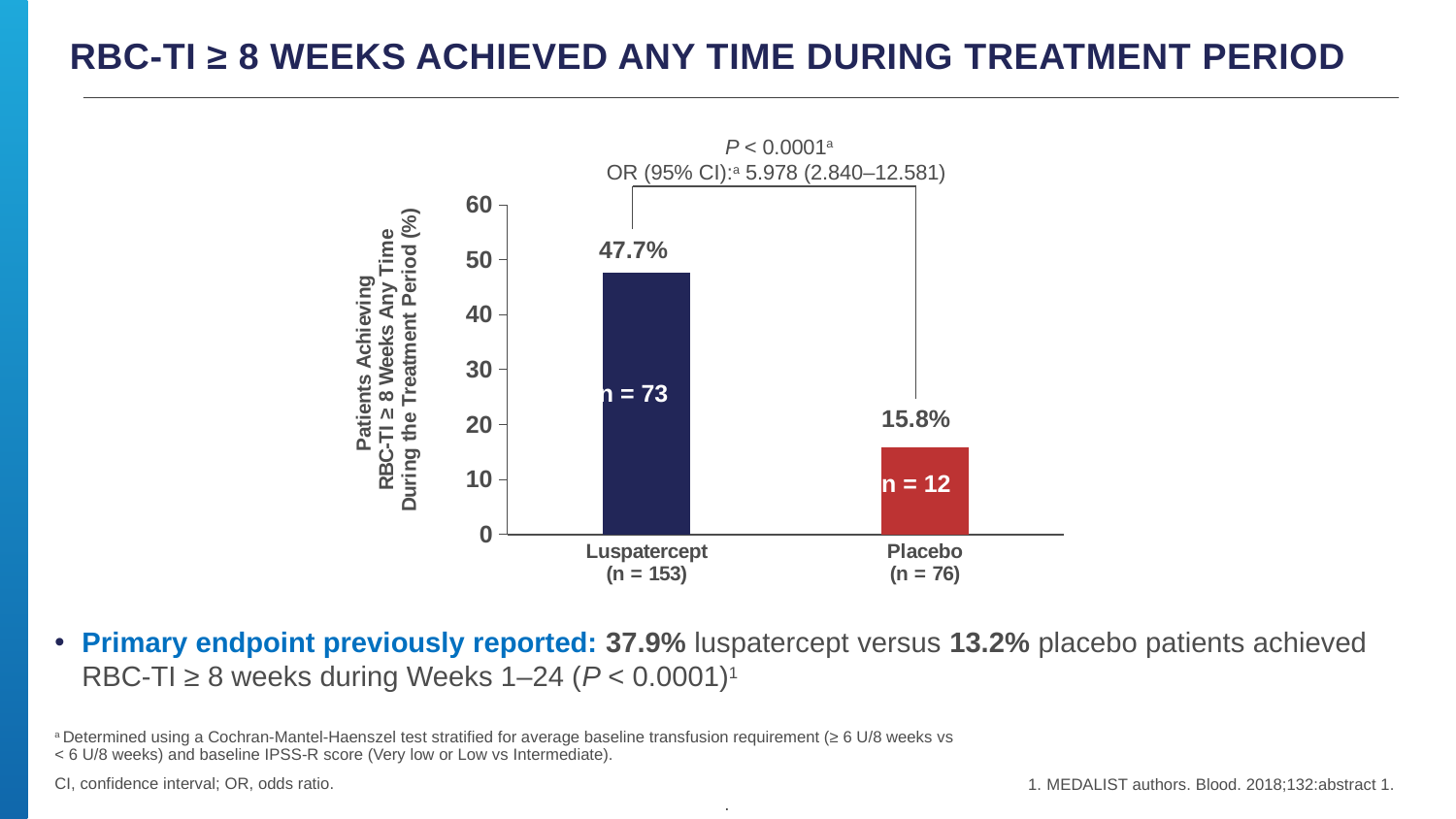
Is the value for the placebo bar greater or less than 20? less Which treatment group has the lower percentage of patients achieving RBC-TI ≥ 8 weeks? Placebo How many patients in the placebo group achieved RBC-TI ≥ 8 weeks (n shown on the bar)? n = 12 What is the odds ratio (95% CI) shown above the chart? 5.978 (2.840–12.581) How many patients in the luspatercept group achieved RBC-TI ≥ 8 weeks (n shown on the bar)? n = 73 What is the difference in percentage points between the luspatercept and placebo bars? 31.9 What percentage of luspatercept patients achieved RBC-TI ≥ 8 weeks any time during the treatment period? 47.7% Is the value for the luspatercept bar greater or less than 40? greater What kind of chart is shown on the slide? Bar chart Which treatment group has the higher percentage of patients achieving RBC-TI ≥ 8 weeks? Luspatercept How many treatment groups are plotted in the chart? 2 What percentage of placebo patients achieved RBC-TI ≥ 8 weeks any time during the treatment period? 15.8%